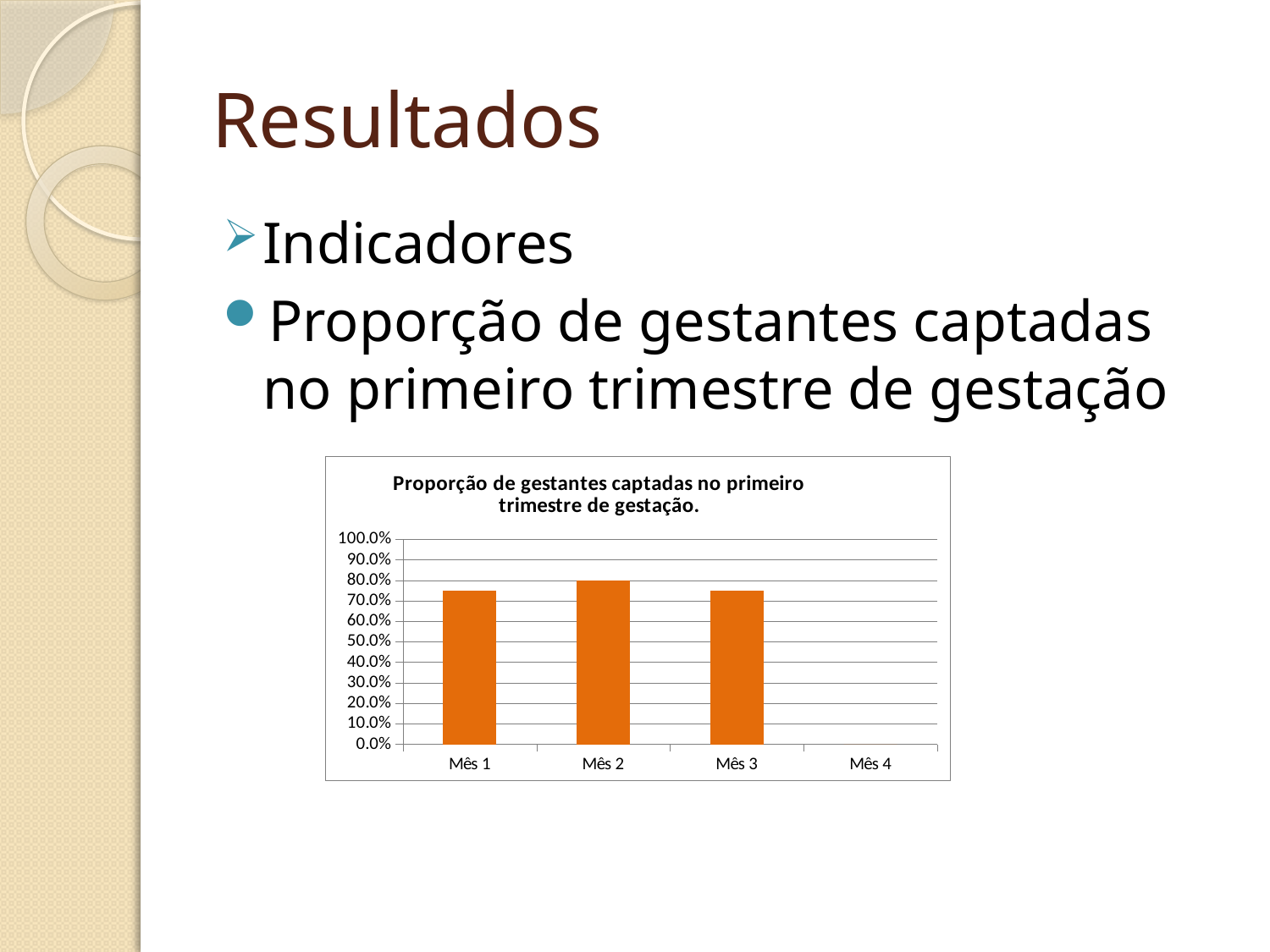
What is the title of the chart? Proporção de gestantes captadas no primeiro trimestre de gestação. What is the value for Mês 2? 80.0% Is the value for Mês 3 greater or less than 80.0%? less Which month has the highest value in the chart? Mês 2 Is the value for Mês 1 greater or less than 80.0%? less Which is larger, the value for Mês 2 or the value for Mês 3? Mês 2 Which is larger, the value for Mês 1 or the value for Mês 4? Mês 1 What kind of chart is shown on the slide? bar chart Is the value for Mês 1 greater or less than 70.0%? greater Which month has the lowest value in the chart? Mês 4 How many categories are shown on the x axis of the chart? 4 What colour are the bars in the chart? orange